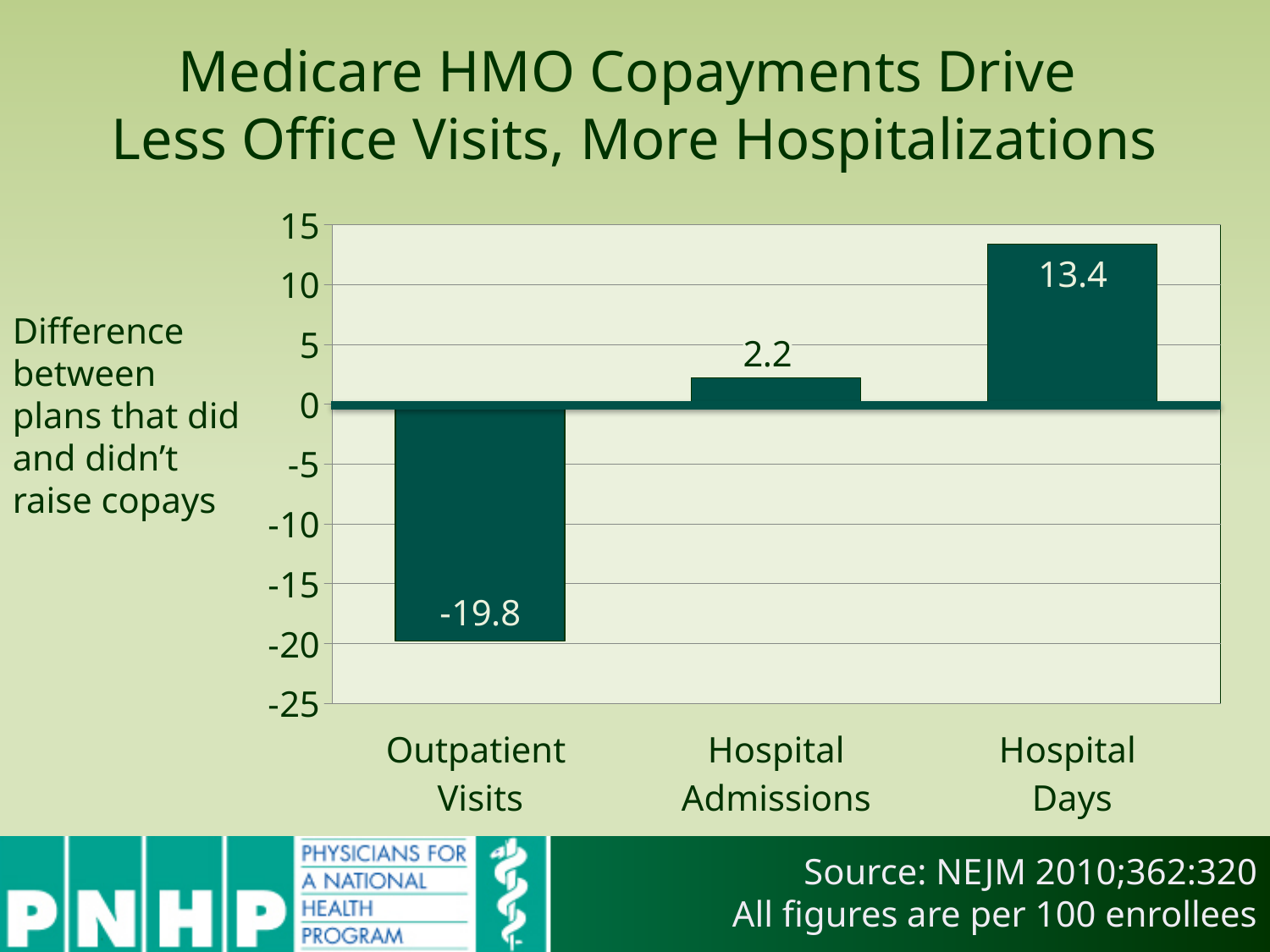
What kind of chart is shown on the slide? bar chart Do the values rise or fall from Outpatient Visits to Hospital Days along the x axis? rise Which is larger, the value for Hospital Admissions or the value for Hospital Days? Hospital Days What is the value for Hospital Admissions? 2.2 Which category has the highest value? Hospital Days How many categories are shown on the x axis? 3 What is the value for Outpatient Visits? -19.8 What is the value for Hospital Days? 13.4 What is the title of the slide? Medicare HMO Copayments Drive Less Office Visits, More Hospitalizations What is the difference between the values for Hospital Days and Hospital Admissions? 11.2 Is the value for Outpatient Visits greater or less than -15? less Which category has the lowest value? Outpatient Visits